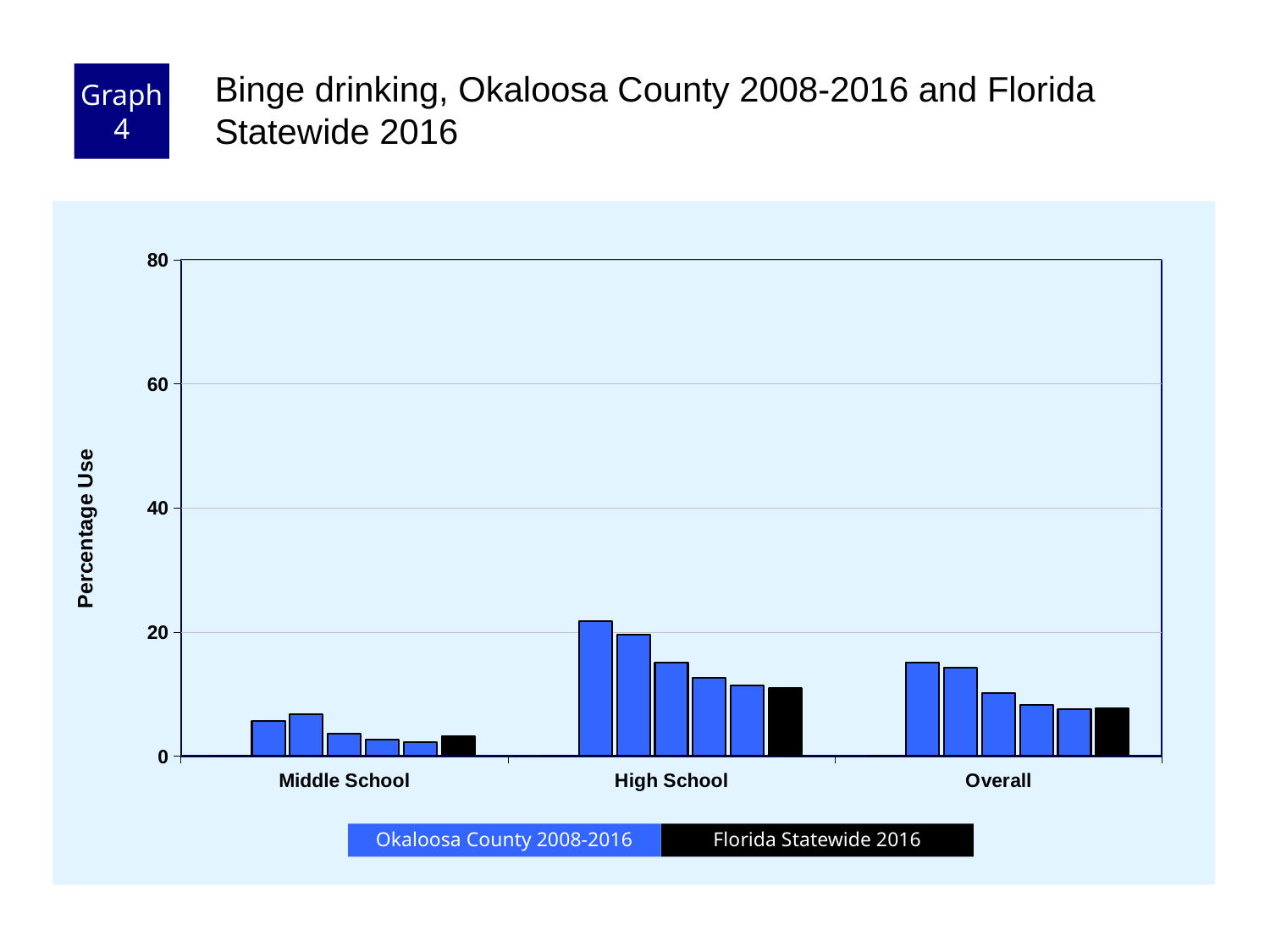
Is the Florida Statewide 2016 value for Middle School greater or less than 20? less What is the label on the y axis? Percentage Use What colour are the Florida Statewide 2016 bars? black Do the Okaloosa County 2008-2016 bars for High School rise or fall from left to right? fall How many categories are shown on the x axis? 3 Which category has the lowest bars overall? Middle School What kind of chart is shown on the slide? bar chart How many series does the legend list? 2 Is the Florida Statewide 2016 value for Overall greater or less than 20? less Which category has the tallest bar? High School Is the tallest High School bar greater or less than 20? greater Which is larger, the Florida Statewide 2016 value for High School or for Middle School? High School